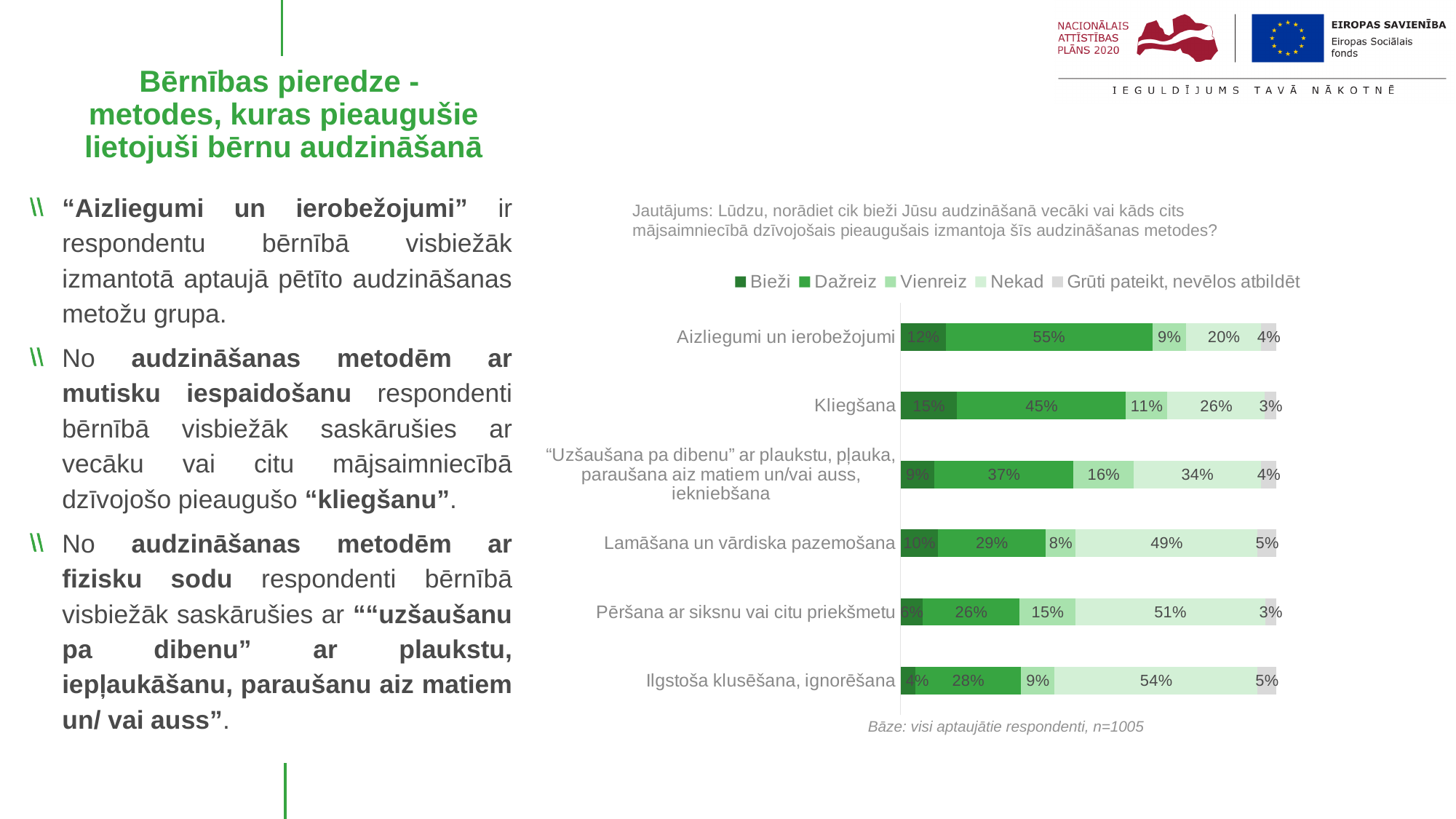
Which category has the highest "Bieži" value? Kliegšana What kind of chart is shown on the slide? Stacked horizontal bar chart What is the "Grūti pateikt, nevēlos atbildēt" value for "Lamāšana un vārdiska pazemošana"? 5% How many series does the legend list? 5 What is the difference between the "Nekad" values for "Pēršana ar siksnu vai citu priekšmetu" and "Kliegšana"? 25 percentage points How many categories (parenting methods) are shown in the chart? 6 Which category has the lowest "Bieži" value? Ilgstoša klusēšana, ignorēšana What is the base (number of respondents) stated below the chart? n=1005 Which has a larger "Vienreiz" value: "Kliegšana" or "Uzšaušana pa dibenu ar plaukstu, pļauka, paraušana aiz matiem un/vai auss, iekniebšana"? Uzšaušana pa dibenu ar plaukstu, pļauka, paraušana aiz matiem un/vai auss, iekniebšana What percentage of respondents answered "Dažreiz" for "Aizliegumi un ierobežojumi"? 55% Which category has the highest "Nekad" value? Ilgstoša klusēšana, ignorēšana What is the "Nekad" value for "Ilgstoša klusēšana, ignorēšana"? 54%